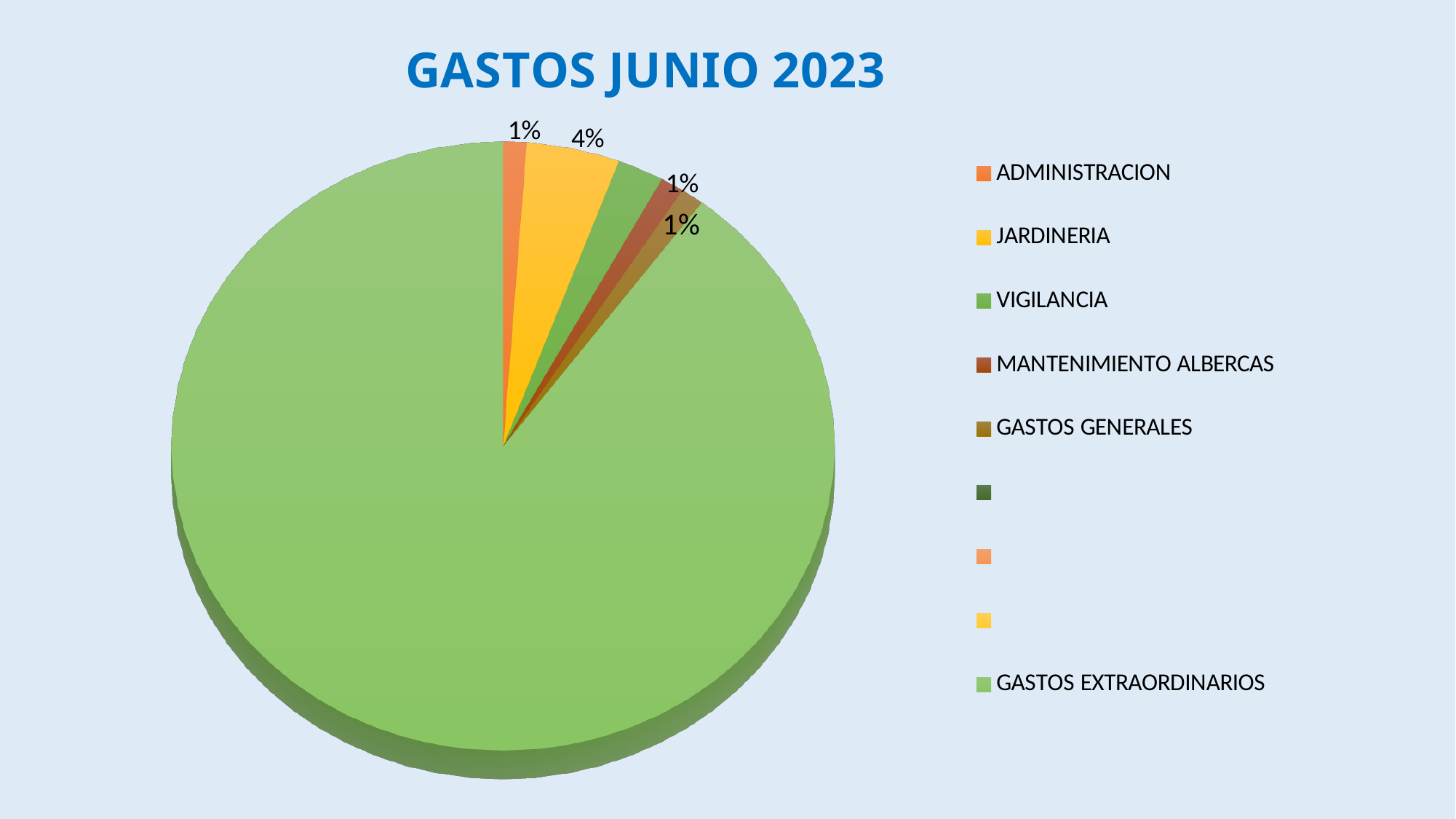
Which category takes up the largest share of the pie? GASTOS EXTRAORDINARIOS What percentage of the pie does ADMINISTRACION represent? 1% What kind of chart is shown on the slide? pie chart How many legend entries have a readable category name? 6 What colour is the GASTOS EXTRAORDINARIOS slice? green What percentage of the pie does JARDINERIA represent? 4% Which is larger, the share for JARDINERIA or the share for ADMINISTRACION? JARDINERIA What is the title of the chart? GASTOS JUNIO 2023 By how many percentage points does JARDINERIA exceed ADMINISTRACION? 3% What percentage of the pie does GASTOS GENERALES represent? 1% What percentage of the pie does MANTENIMIENTO ALBERCAS represent? 1% Which is larger, the share for GASTOS EXTRAORDINARIOS or the share for JARDINERIA? GASTOS EXTRAORDINARIOS